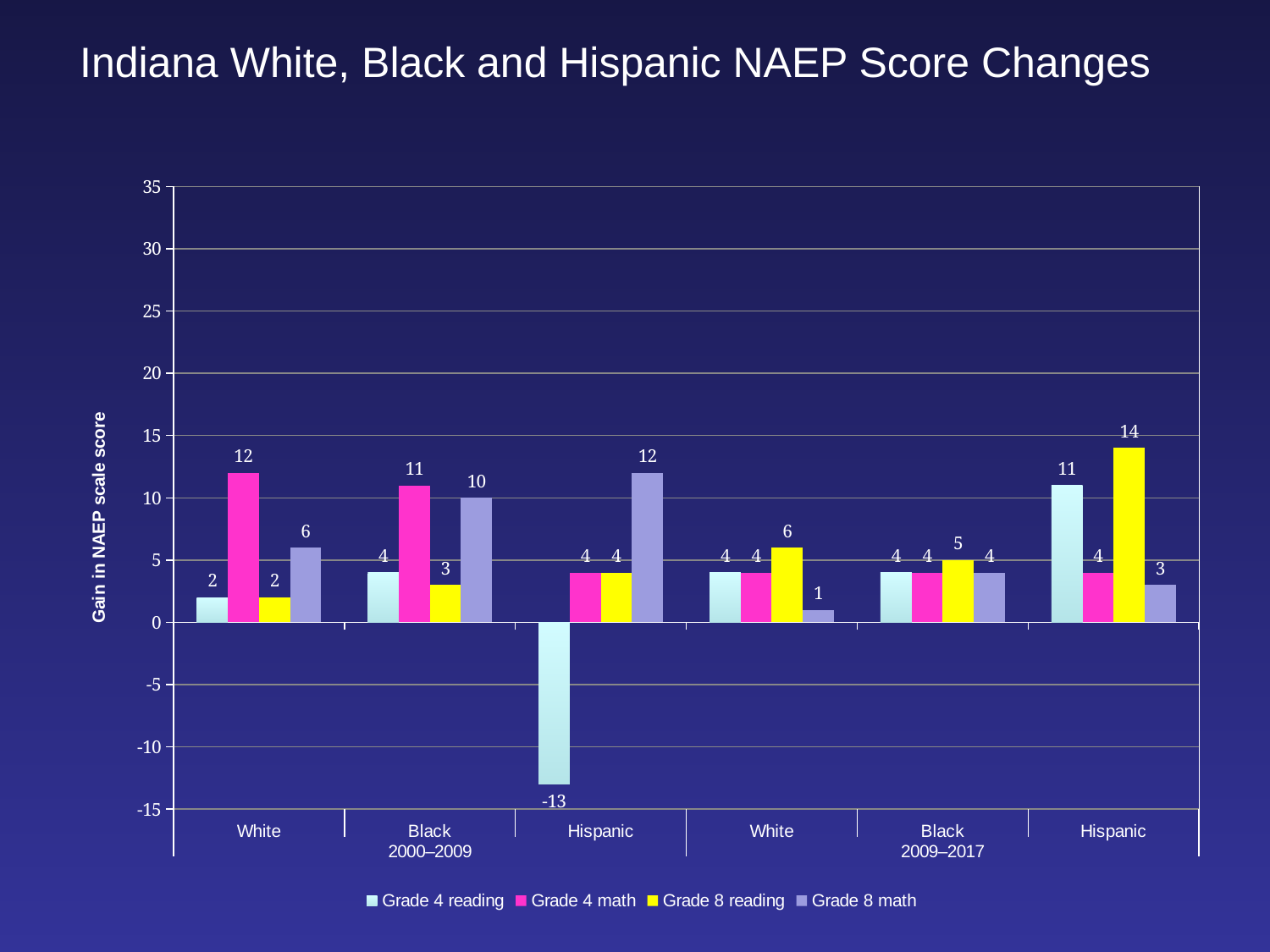
Which series has the highest value for Hispanic students in 2009–2017? Grade 8 reading How many category groups are shown along the x axis? 6 Which is larger: the Grade 4 math gain for White students in 2000–2009 or the Grade 4 math gain for White students in 2009–2017? 2000–2009 What kind of chart is shown on the slide? Bar chart Which series has the lowest value for Hispanic students in 2000–2009? Grade 4 reading What is the Grade 8 math gain for Black students in 2000–2009? 10 What is the Grade 8 reading gain for Hispanic students in 2009–2017? 14 What is the label of the y axis? Gain in NAEP scale score What is the Grade 4 math gain for White students in 2000–2009? 12 What is the difference between the Grade 8 math gain for Hispanic students in 2000–2009 and the Grade 8 math gain for Hispanic students in 2009–2017? 9 How many series does the legend list? 4 What is the Grade 4 reading gain for Hispanic students in 2000–2009? -13